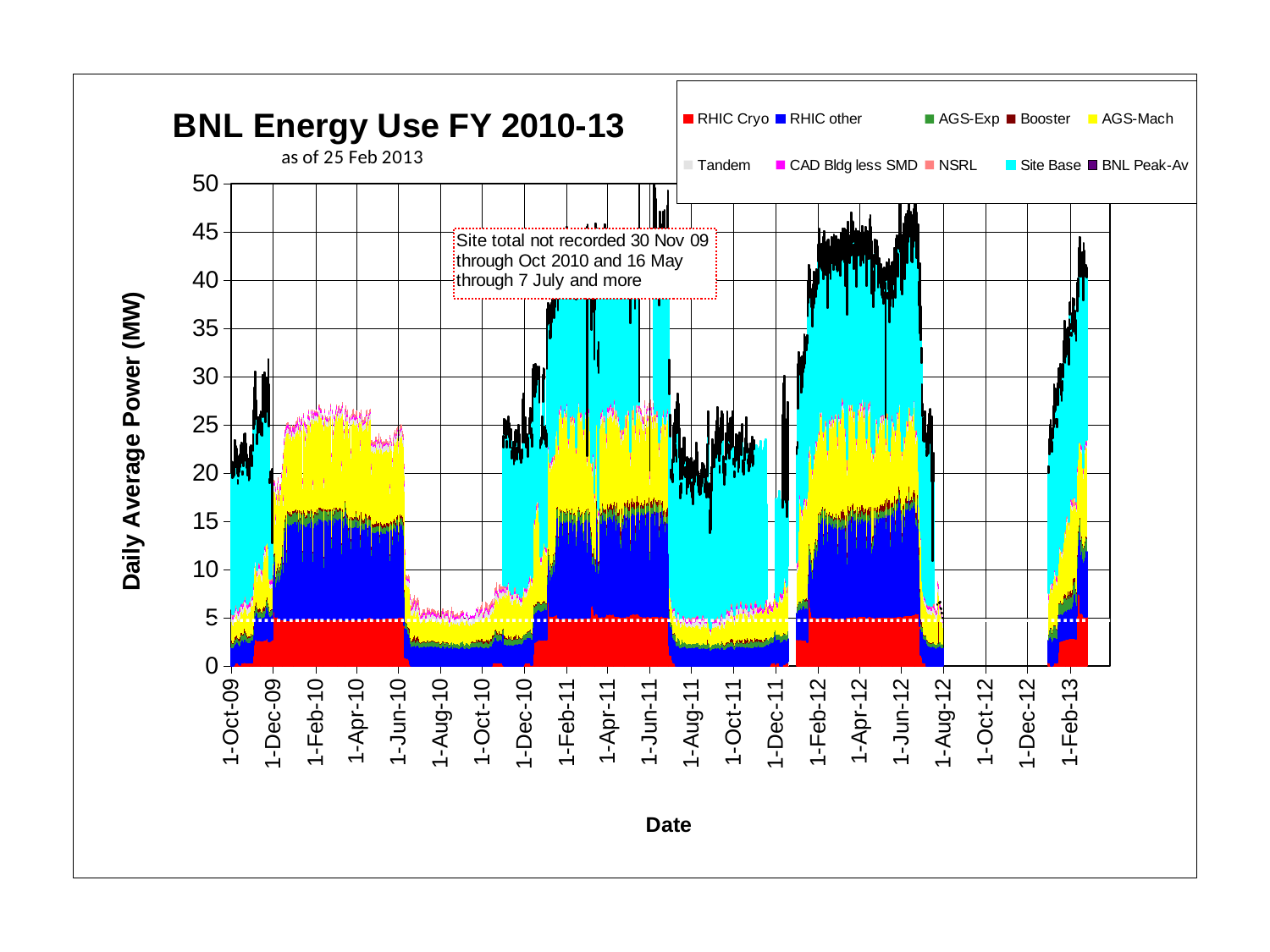
Is the total stacked daily average power around 1-Aug-10 greater or less than 10? less Does the total stacked daily average power rise or fall from 1-Jun-10 to 1-Aug-10? fall What kind of chart is shown on the slide? Stacked area chart Is the RHIC Cryo value around 1-Apr-11 greater or less than 10? less How many series does the legend list? 10 What is the title of the chart? BNL Energy Use FY 2010-13 Which is larger, the total stacked daily average power around 1-Apr-12 or around 1-Aug-10? 1-Apr-12 Which is larger, the total stacked daily average power around 1-Apr-10 or around 1-Oct-10? 1-Apr-10 Is the total stacked daily average power around 1-Apr-10 greater or less than 20? greater What is the label of the vertical axis? Daily Average Power (MW)